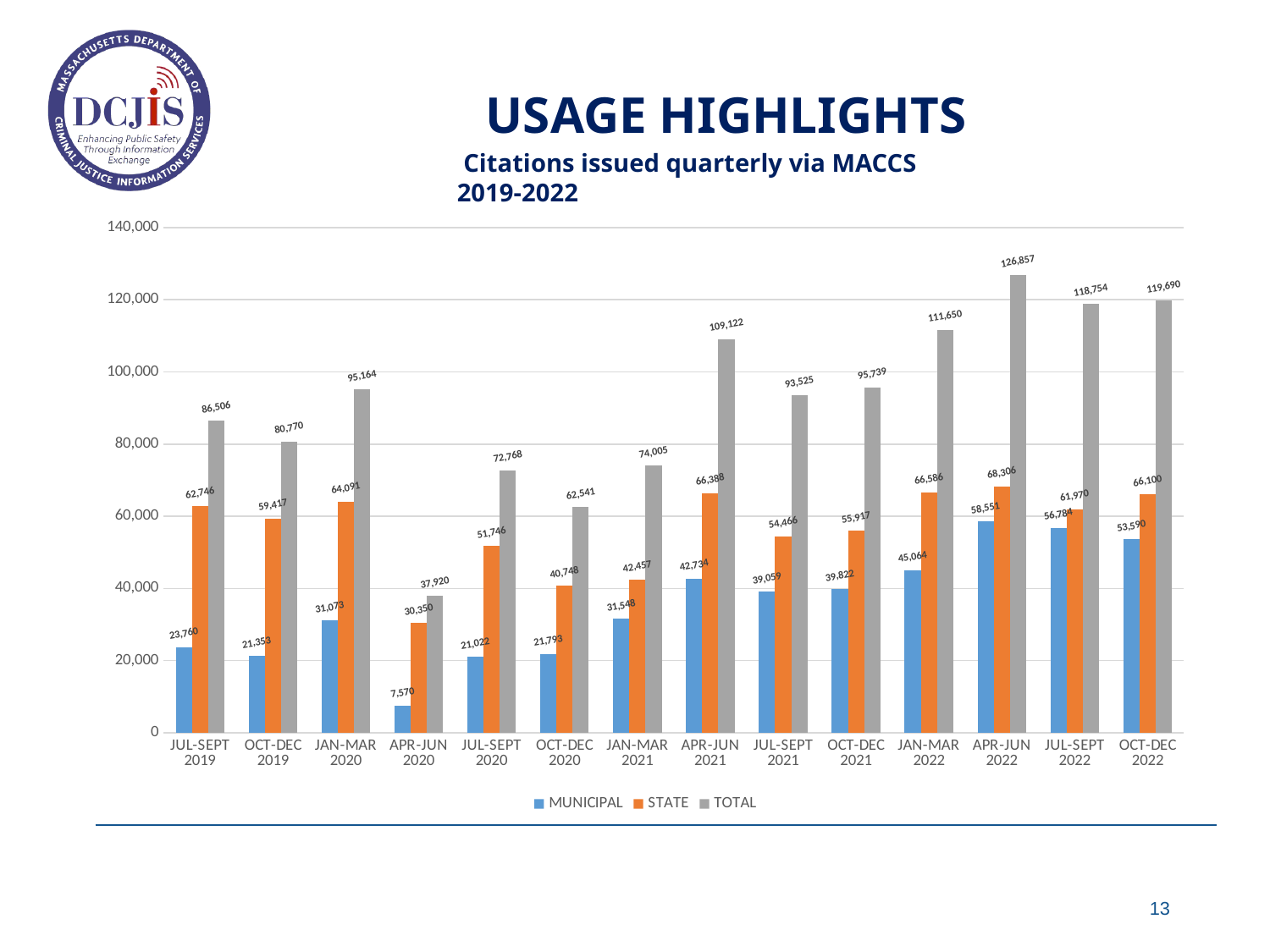
What is the difference between the TOTAL values for APR-JUN 2022 and APR-JUN 2020? 88,937 Which is larger, the STATE value for OCT-DEC 2020 or the STATE value for JAN-MAR 2021? JAN-MAR 2021 How many series does the legend list? 3 What is the STATE value for OCT-DEC 2020? 40,748 Which quarter has the lowest MUNICIPAL value? APR-JUN 2020 Which quarter has the highest TOTAL value? APR-JUN 2022 What is the difference between the STATE and MUNICIPAL values for JUL-SEPT 2019? 38,986 Is the TOTAL value for JAN-MAR 2022 greater or less than 100,000? greater What is the TOTAL value for APR-JUN 2022? 126,857 How many quarters are shown on the x axis? 14 What is the MUNICIPAL value for JUL-SEPT 2019? 23,760 What kind of chart is shown on the slide? bar chart